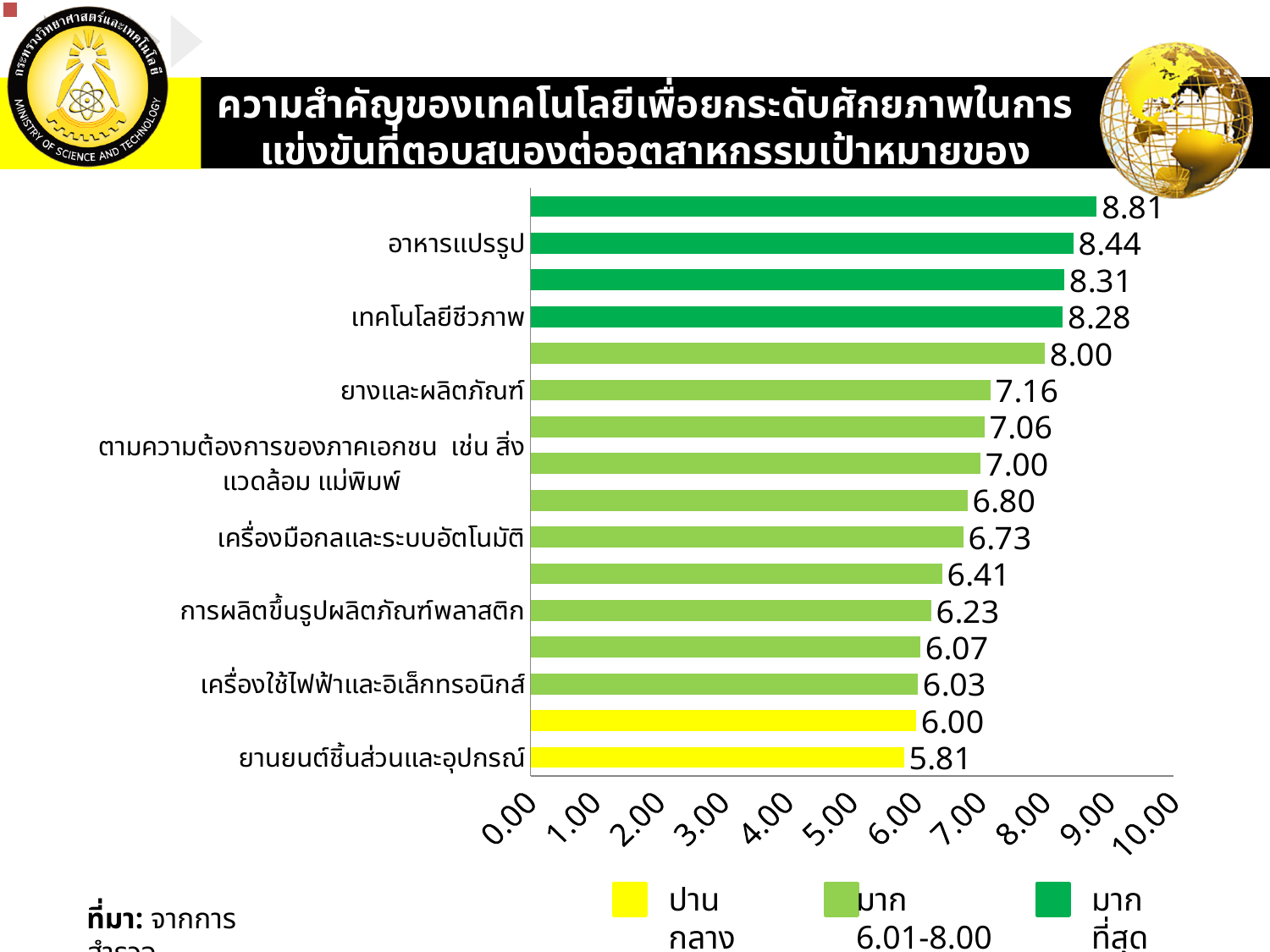
Which labelled category has the lowest value? ยานยนต์ชิ้นส่วนและอุปกรณ์ What is the highest value shown on the chart? 8.81 What is the value for ยานยนต์ชิ้นส่วนและอุปกรณ์? 5.81 What is the value for เทคโนโลยีชีวภาพ? 8.28 Which is larger, the value for การผลิตขึ้นรูปผลิตภัณฑ์พลาสติก or the value for เครื่องใช้ไฟฟ้าและอิเล็กทรอนิกส์? การผลิตขึ้นรูปผลิตภัณฑ์พลาสติก What is the value for เครื่องมือกลและระบบอัตโนมัติ? 6.73 How many bars are plotted on the chart? 16 What is the difference between the values for อาหารแปรรูป and เทคโนโลยีชีวภาพ? 0.16 What kind of chart is shown on the slide? Bar chart What is the value for ยางและผลิตภัณฑ์? 7.16 How many entries does the legend list? 3 What is the value for อาหารแปรรูป? 8.44